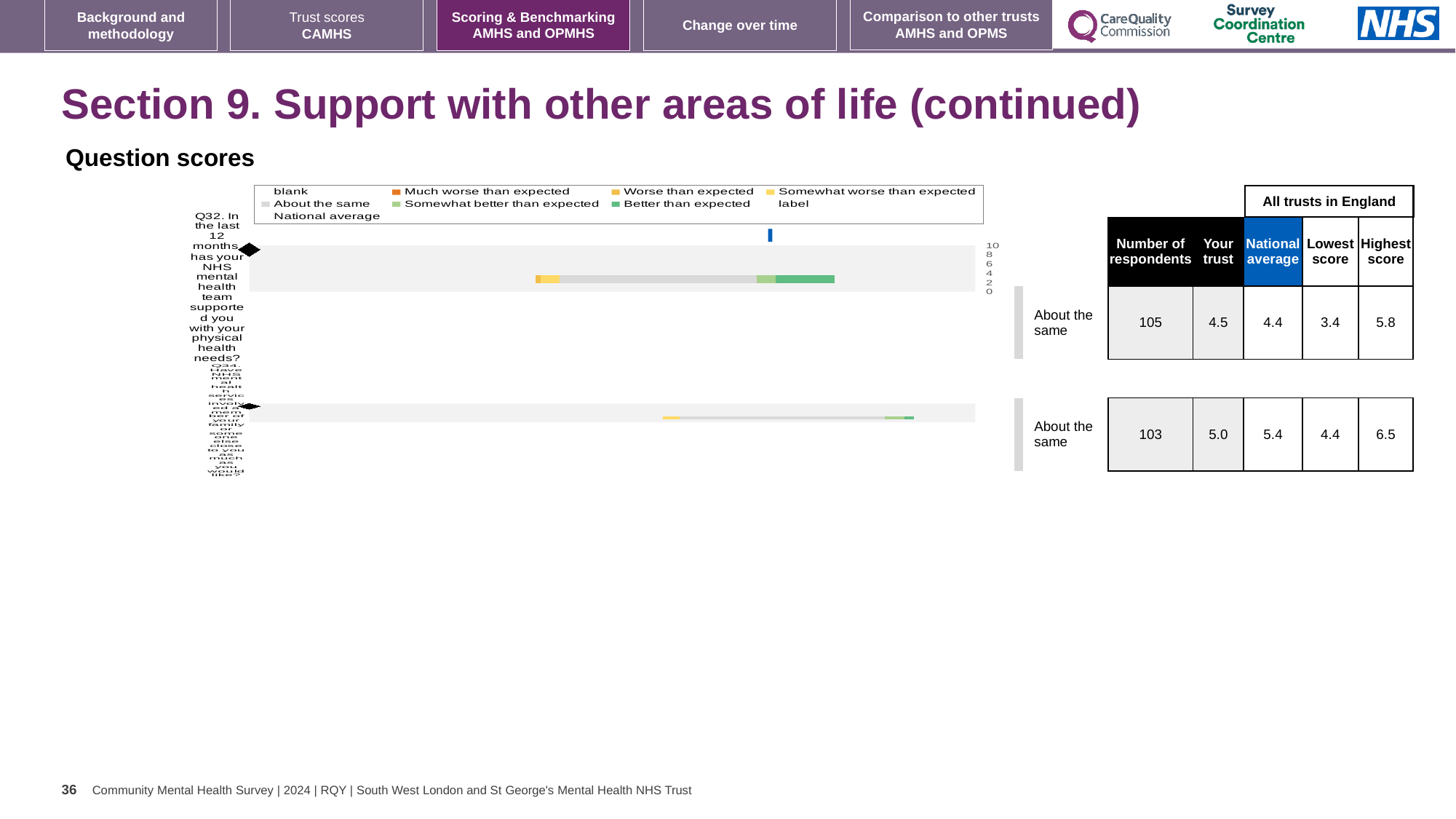
What is the difference between the highest score and the lowest score for Q34? 2.1 How many entries does the chart legend list? 9 What is the national average score for Q34? 5.4 What is the 'Your trust' score for Q32 (support with physical health needs)? 4.5 What benchmark category is shown for both Q32 and Q34? About the same What is the 'Your trust' score for Q34 (involving family or someone close)? 5.0 How many respondents answered Q32? 105 How many survey questions are plotted on the chart? 2 What is the difference between the highest score and the lowest score for Q32? 2.4 What kind of chart is shown on the slide? Bar chart What is the national average score for Q32? 4.4 For Q34, which is larger: the trust's score or the national average? National average